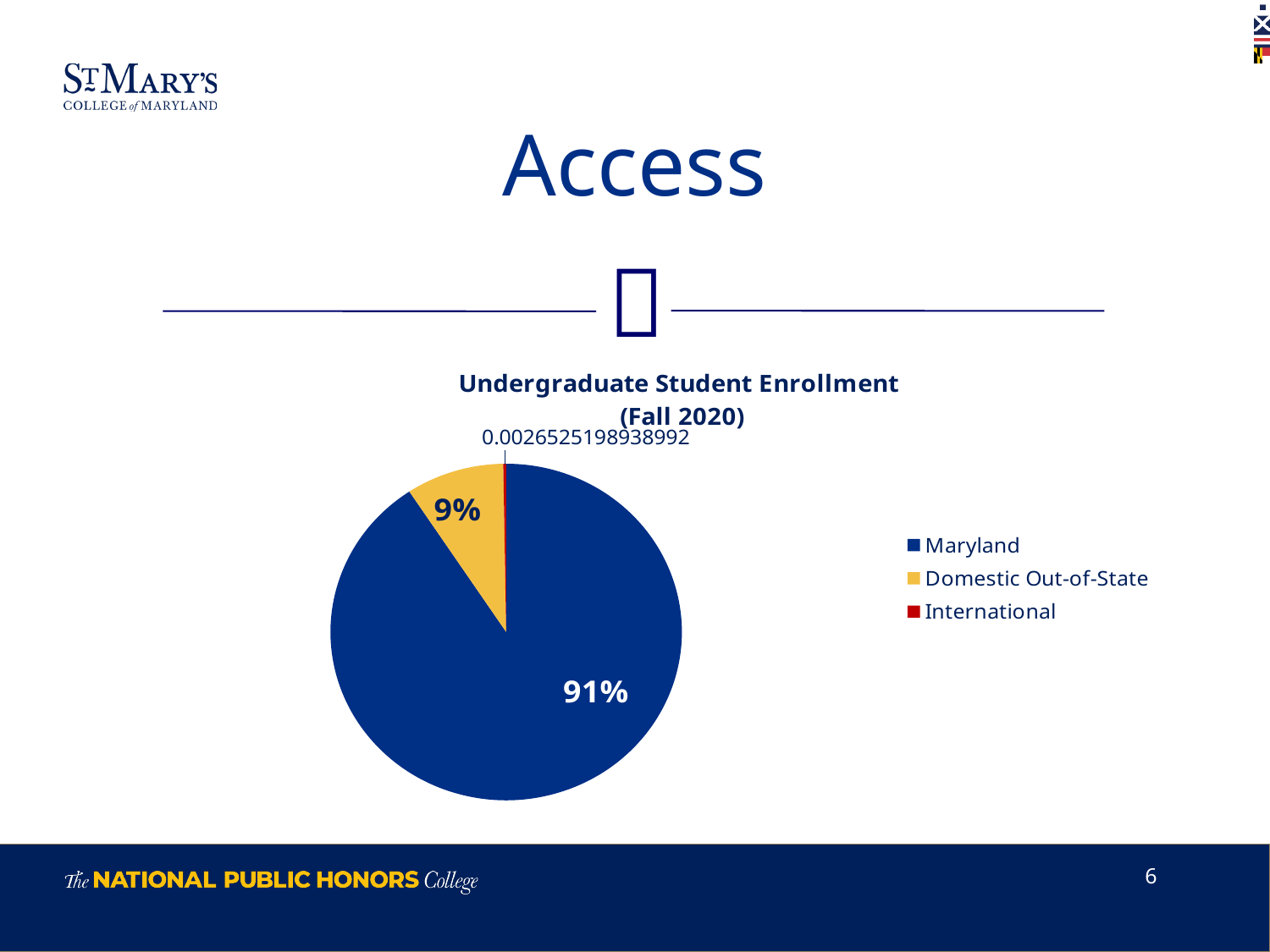
What is the difference in percentage points between the Maryland and Domestic Out-of-State slices? 82% What share of undergraduate enrollment is Domestic Out-of-State? 9% How many slices does the pie chart have? 3 What value is printed on the International slice? 0.0026525198938992 What is the title of the chart? Undergraduate Student Enrollment (Fall 2020) What share of undergraduate enrollment is from Maryland? 91% What colour is the Maryland slice? blue How many categories does the legend list? 3 Which category has the largest slice of the pie? Maryland What kind of chart is shown on the slide? pie chart Which is larger, the Domestic Out-of-State slice or the International slice? Domestic Out-of-State Which category has the smallest slice of the pie? International